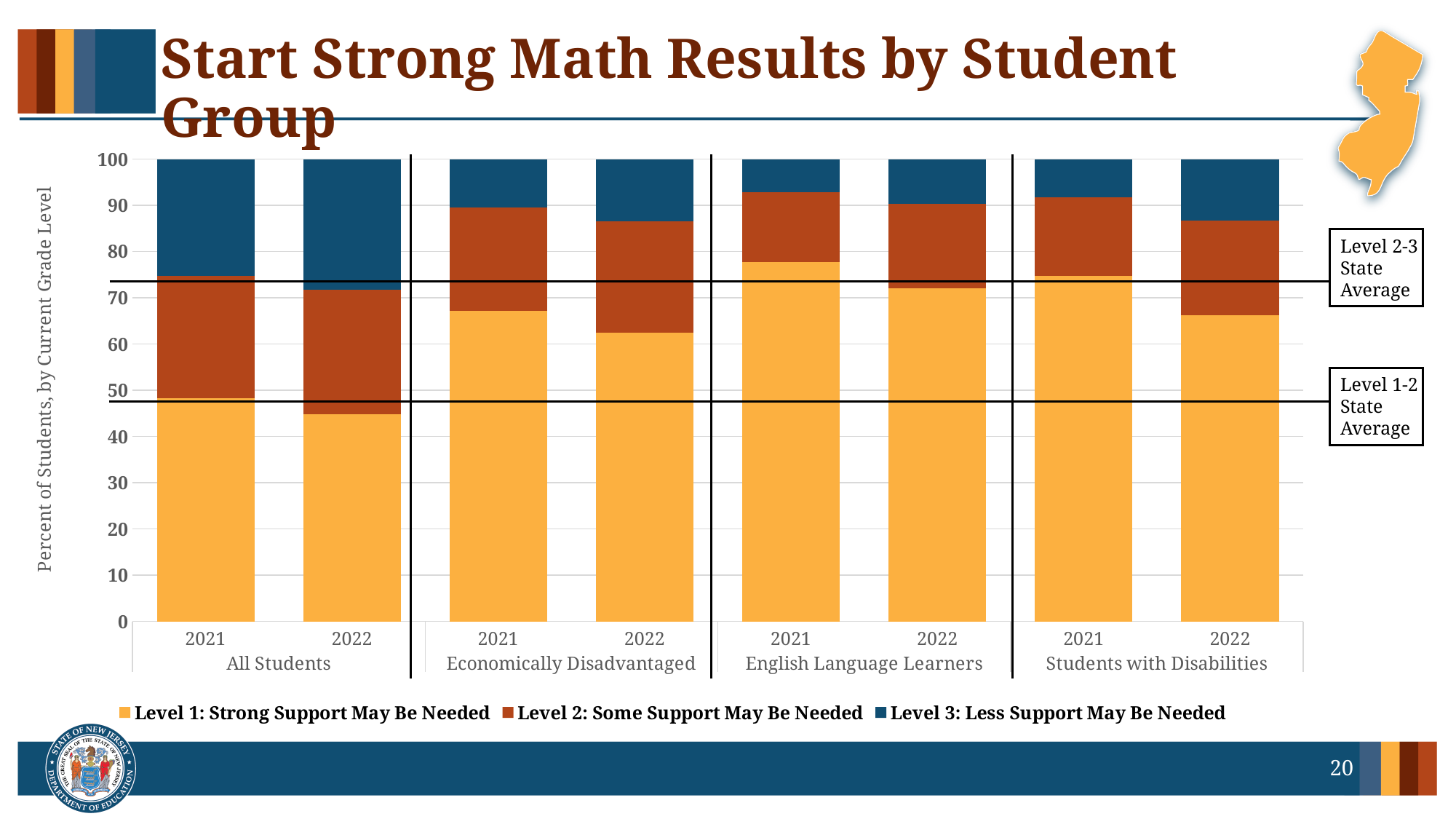
Is the Level 1 value for All Students in 2022 greater or less than 50? less Which student group has the largest Level 1 share in 2021? English Language Learners What is the total of the stacked bar for All Students in 2021? 100 Is the Level 1 value for English Language Learners in 2021 greater or less than 70? greater Which student group has the smallest Level 1 share in 2022? All Students For Students with Disabilities, does the Level 1 share rise or fall from 2021 to 2022? Fall Is the Level 1 value for Economically Disadvantaged students in 2021 greater or less than 60? greater How many stacked bars are plotted in the chart? 8 What kind of chart is shown on the slide? Stacked bar chart How many series does the legend list? 3 For All Students, is the Level 1 share larger in 2021 or in 2022? 2021 How many student groups are shown along the x axis? 4